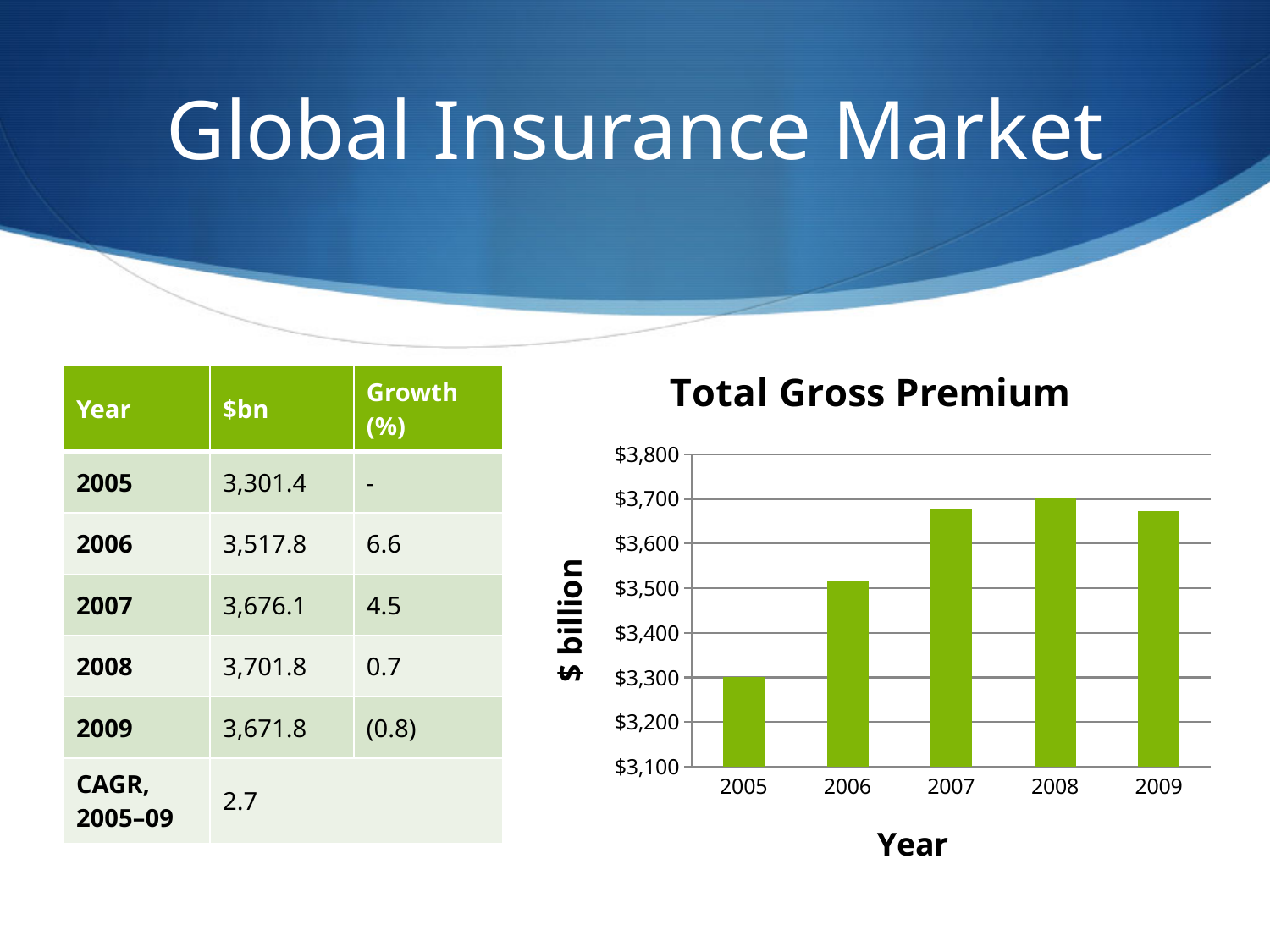
In the Total Gross Premium chart, is the value for 2005 greater or less than $3,400? less Which year has the highest bar in the Total Gross Premium chart? 2008 Which year has the lowest bar in the Total Gross Premium chart? 2005 In the Total Gross Premium chart, is the value for 2007 greater or less than $3,600? greater In the Total Gross Premium chart, is the value for 2009 greater or less than $3,700? less According to the slide, what is the total gross premium in $bn for 2008? 3,701.8 What is the label on the vertical axis of the Total Gross Premium chart? $ billion Using the values printed on the slide, what is the difference in $bn between 2006 and 2005? 216.4 What type of chart is shown under the title "Total Gross Premium"? bar chart Is the bar for 2006 taller or shorter than the bar for 2005 in the Total Gross Premium chart? taller How many years are plotted in the Total Gross Premium chart? 5